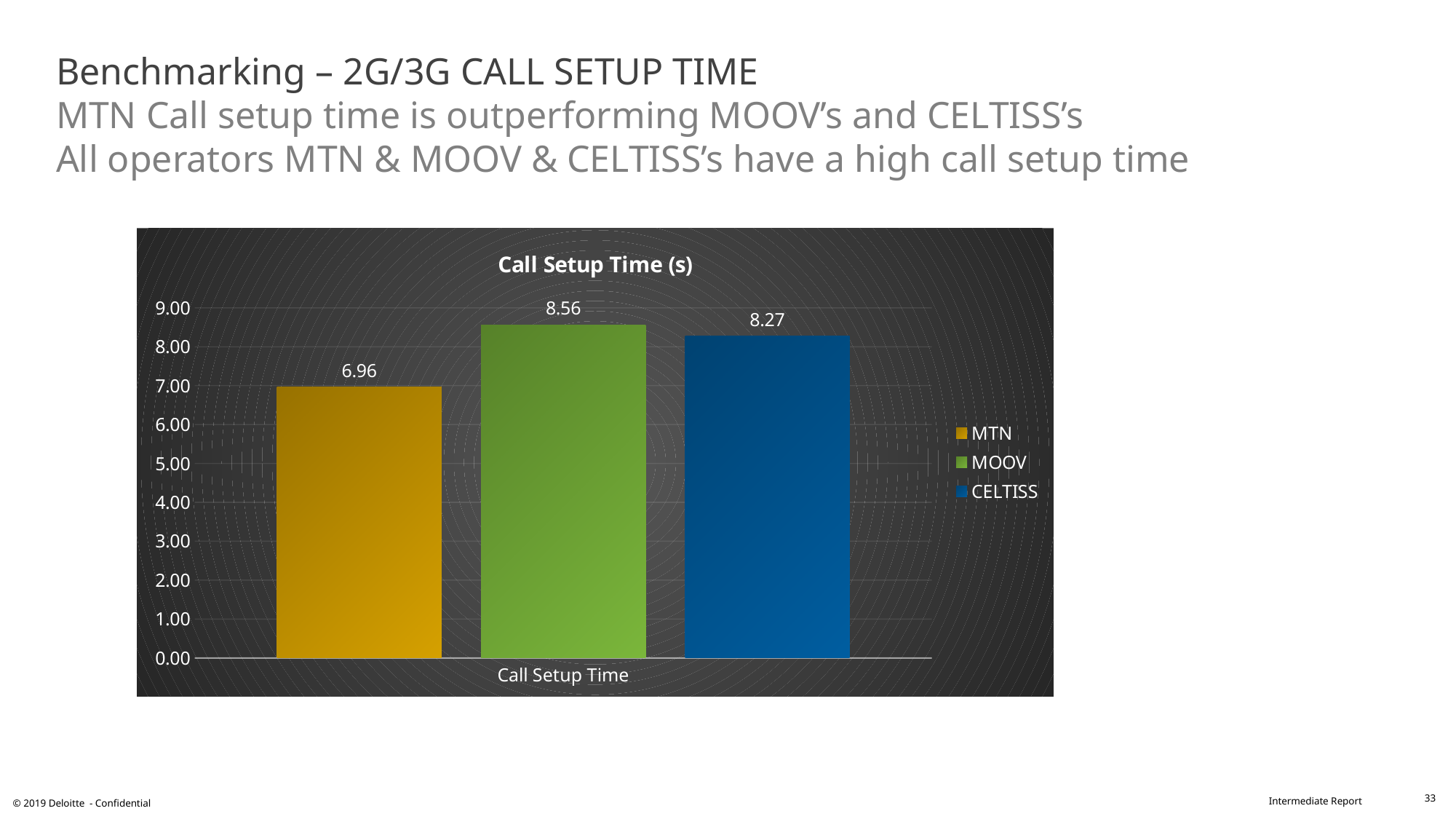
What is the call setup time for CELTISS? 8.27 What is the call setup time for MTN? 6.96 What is the difference between MOOV's and MTN's call setup time? 1.60 Which operator has the lowest call setup time? MTN What kind of chart is shown on the slide? bar chart What is the difference between MOOV's and CELTISS's call setup time? 0.29 What is the title of the chart? Call Setup Time (s) Which operator has the highest call setup time? MOOV What is the call setup time for MOOV? 8.56 How many series does the legend list? 3 Is the call setup time for MTN greater or less than 7.00? less Which has a larger call setup time, CELTISS or MTN? CELTISS